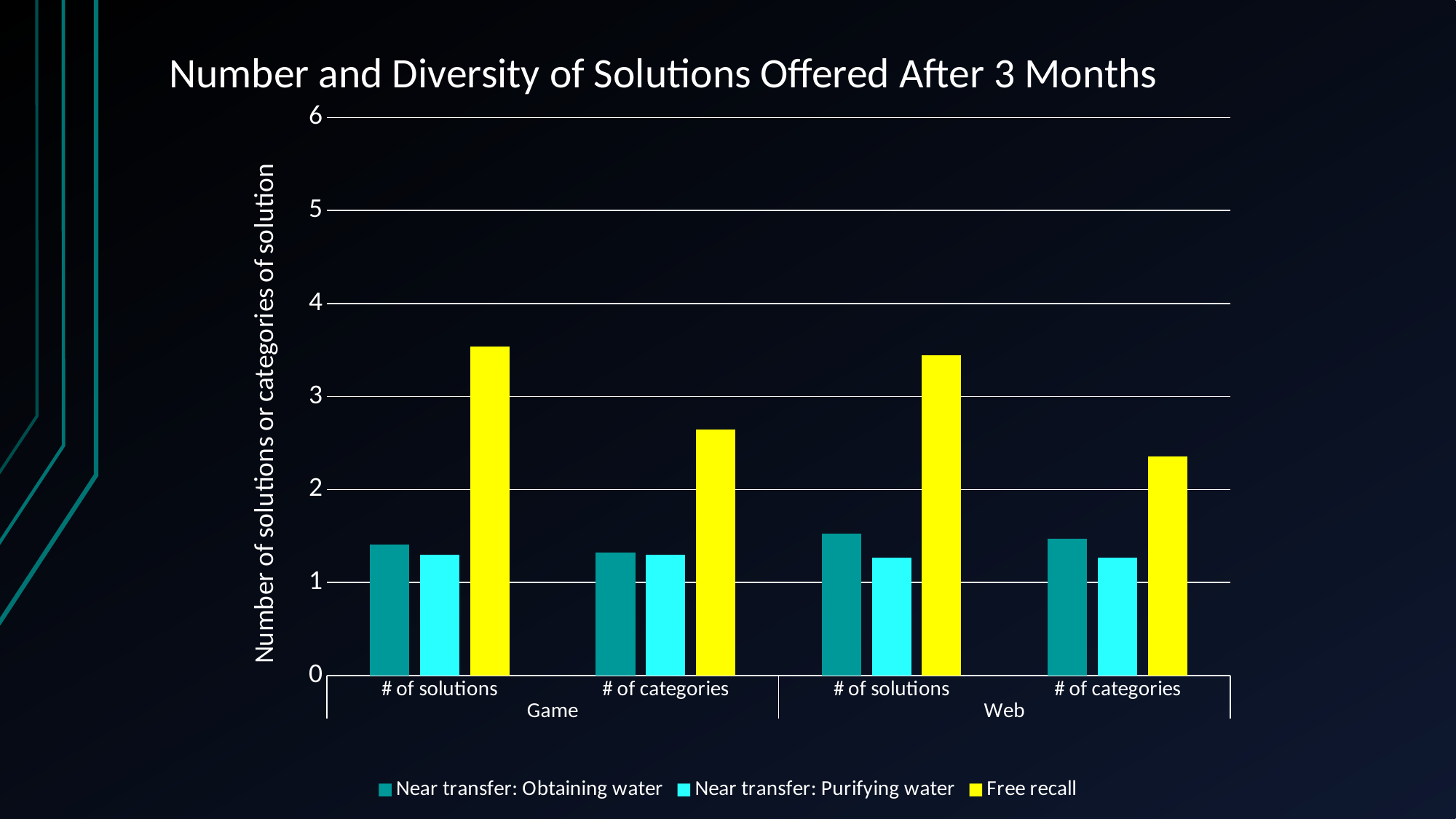
Is the Free recall value for Game # of categories greater or less than 2? greater For Free recall in the Game condition, which is larger: # of solutions or # of categories? # of solutions For Free recall in the Web condition, which is larger: # of solutions or # of categories? # of solutions Is the Free recall value for Web # of categories greater or less than 3? less Is the Free recall value for Game # of solutions greater or less than 3? greater How many series does the legend list? 3 Which series has the highest bar in every category group? Free recall What kind of chart is shown on the slide? Bar chart Within the Web # of solutions group, which series has the lowest bar? Near transfer: Purifying water What is the title of the chart? Number and Diversity of Solutions Offered After 3 Months How many category groups of bars are plotted along the x axis? 4